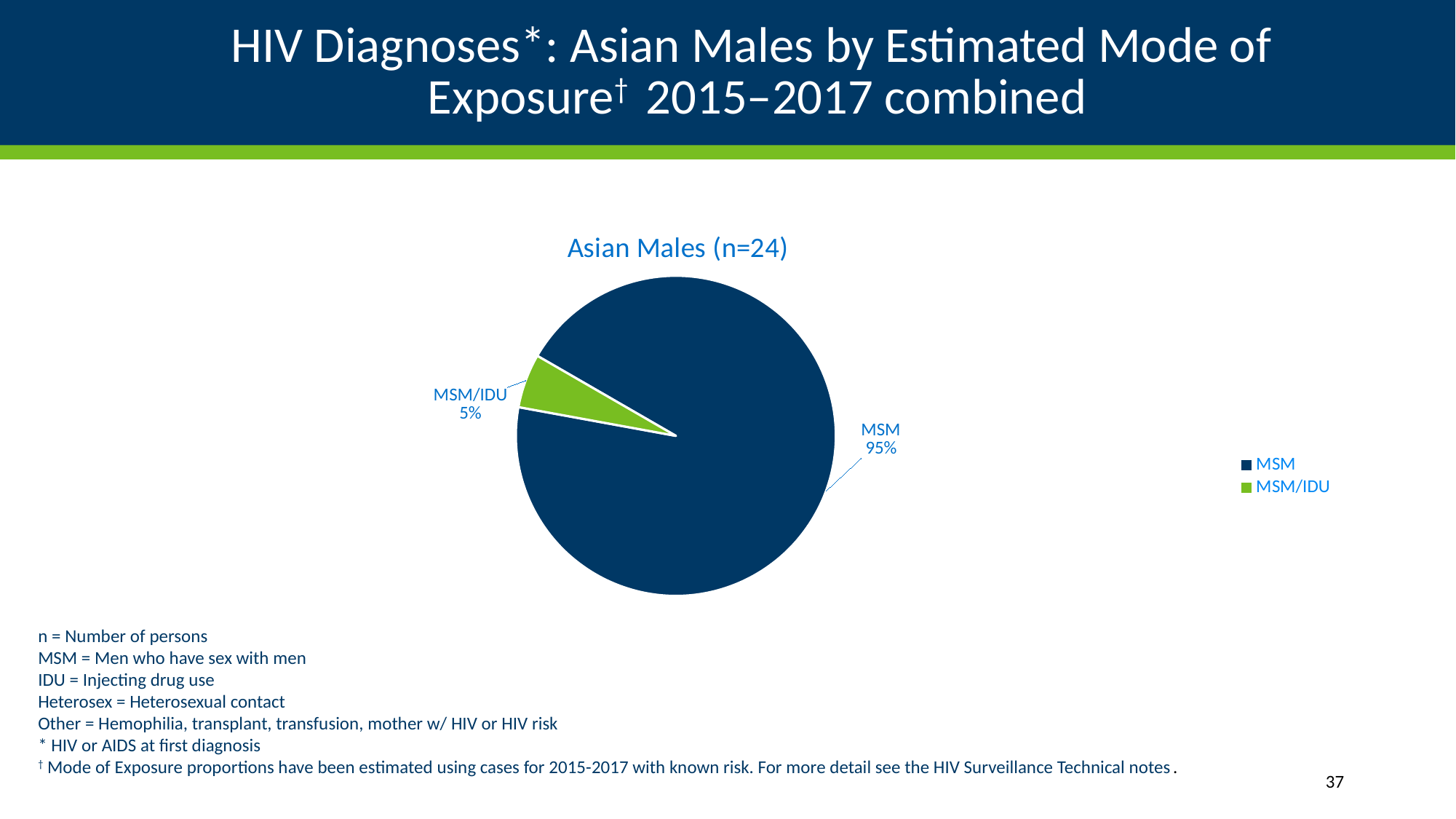
Which slice is larger, MSM or MSM/IDU? MSM What is the title of the pie chart? Asian Males (n=24) What is the number of persons (n) shown in the chart title? 24 How many entries does the legend list? 2 How many slices does the pie chart have? 2 What is the difference in percentage points between the MSM and MSM/IDU slices? 90 What colour is the MSM/IDU slice? green What kind of chart is shown on the slide? pie chart Which mode of exposure has the largest slice of the pie? MSM What share of the pie does MSM/IDU represent? 5% Which mode of exposure has the smallest slice of the pie? MSM/IDU What share of the pie does MSM represent? 95%